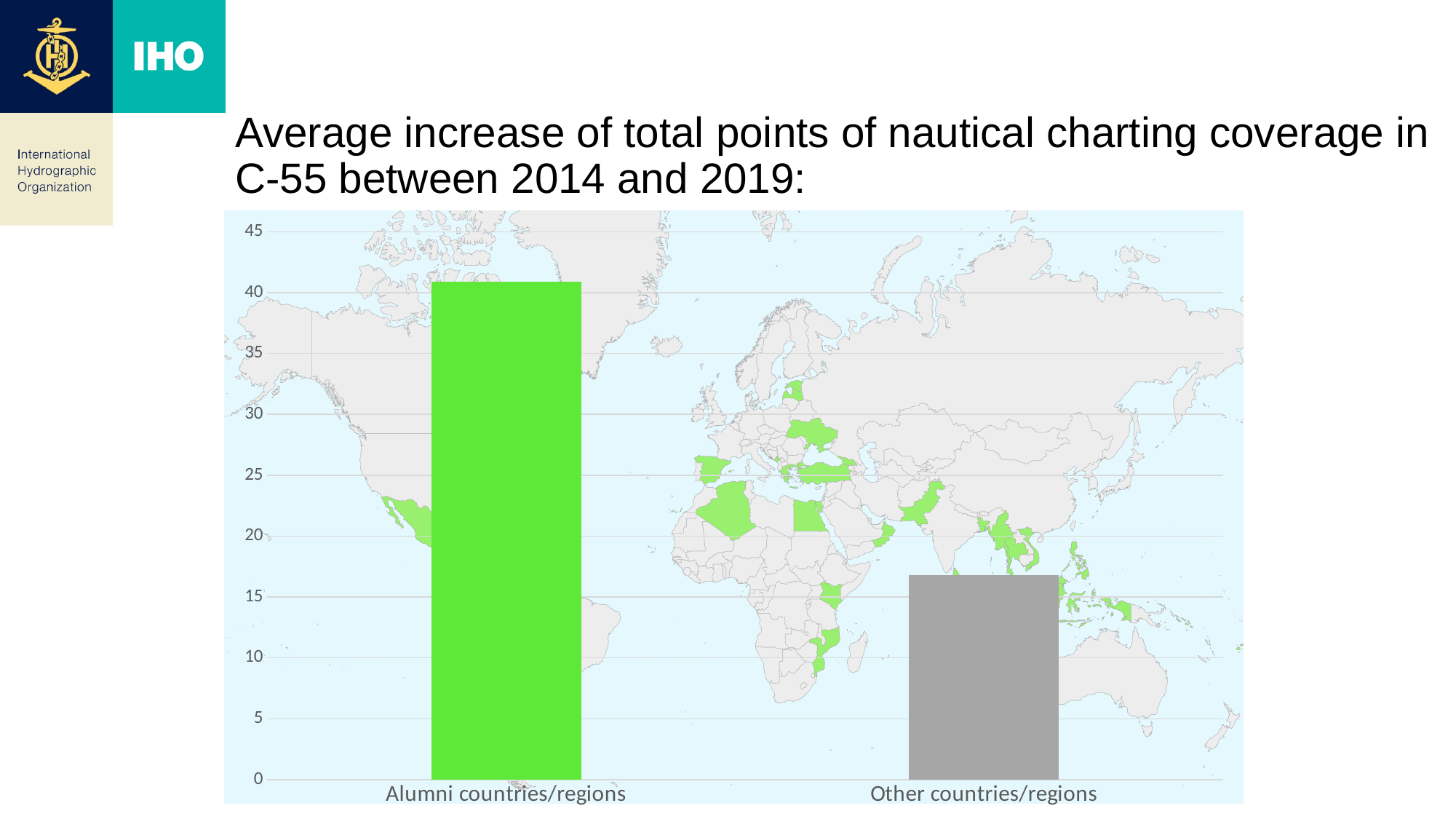
Is the value for Alumni countries/regions greater or less than 45? less How many categories are plotted in the chart? 2 What is the highest tick value shown on the vertical axis of the chart? 45 Is the value for Other countries/regions greater or less than 15? greater What kind of chart is shown on the slide? bar chart Which is larger, the value for Alumni countries/regions or the value for Other countries/regions? Alumni countries/regions Is the value for Alumni countries/regions greater or less than 35? greater What colour is the bar for Alumni countries/regions? green Which category has the lowest value in the chart? Other countries/regions Which category has the highest value in the chart? Alumni countries/regions